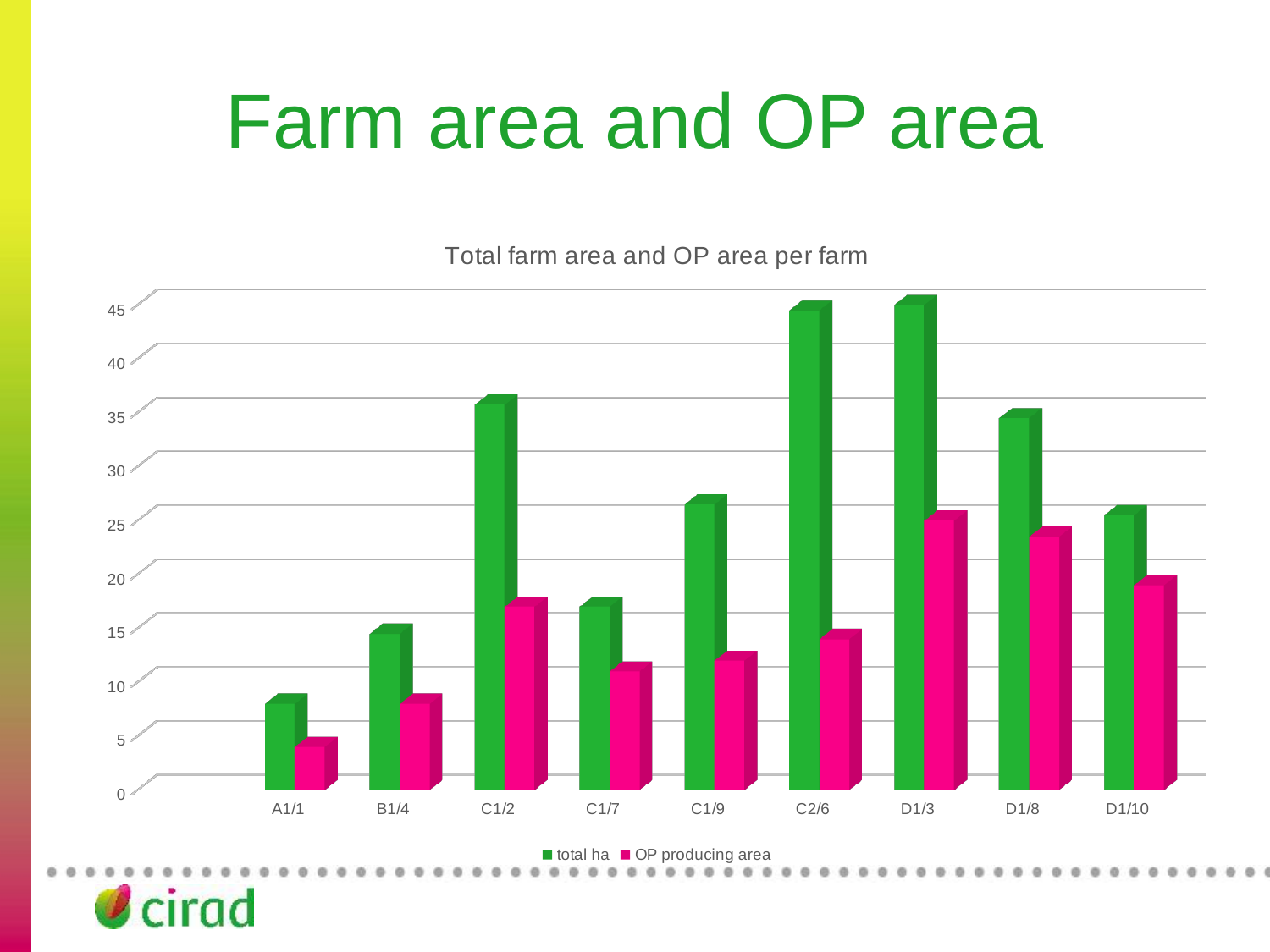
Which farm has the larger total ha value, C1/2 or C1/7? C1/2 What is the title of the chart? Total farm area and OP area per farm Which farm has the lowest OP producing area value? A1/1 Which farm has the larger OP producing area value, D1/8 or C1/7? D1/8 Is the total ha value for C1/2 greater or less than 30? greater How many series does the chart legend list? 2 Which farm has the lowest total ha value? A1/1 What type of chart is shown on the slide? Bar chart How many farms (categories) are shown on the x axis of the chart? 9 Which colour represents the 'OP producing area' series in the chart? Pink Is the total ha value for A1/1 greater or less than 10? less Is the OP producing area value for C2/6 greater or less than 20? less